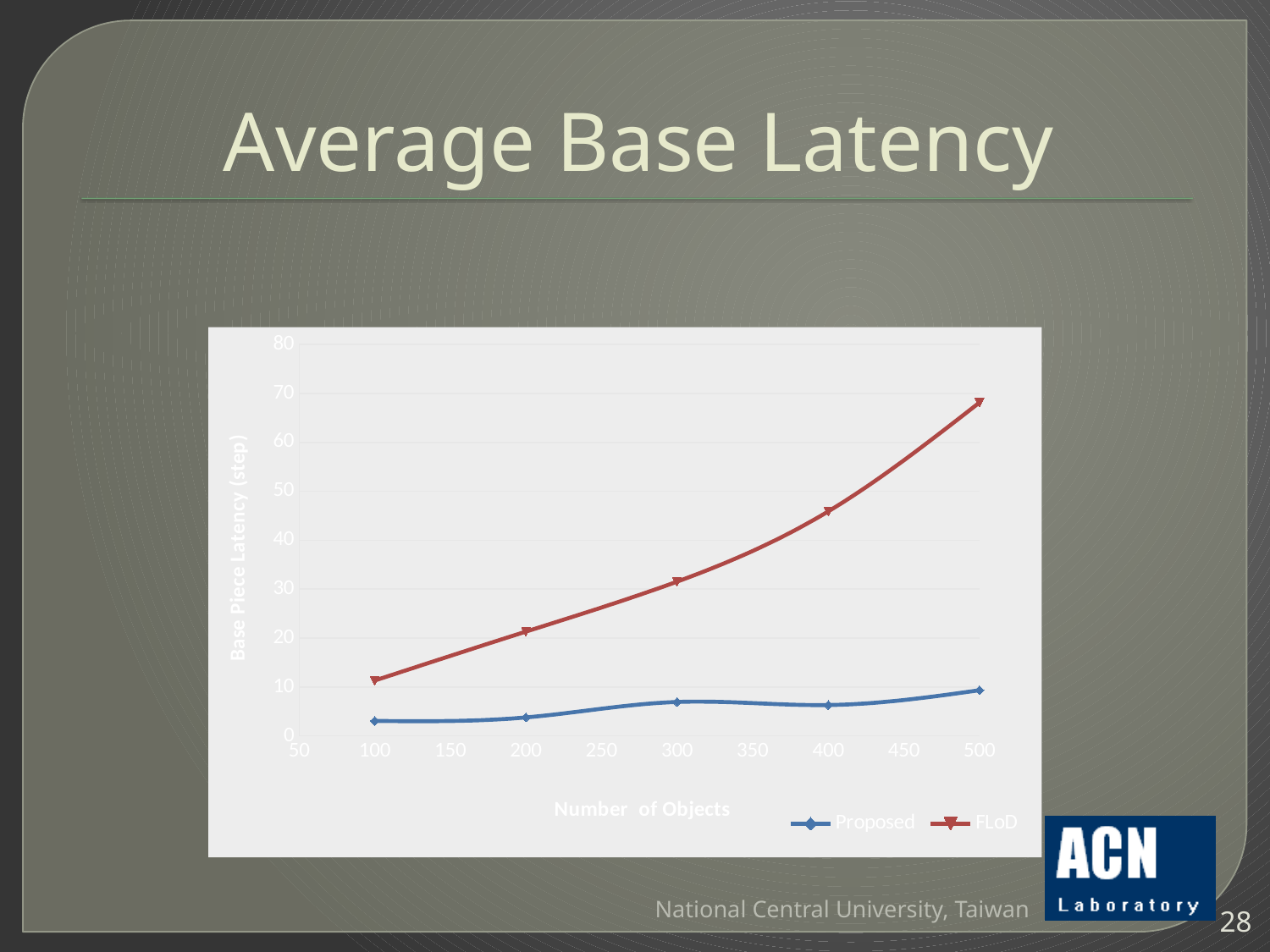
How many series does the legend list? 2 Is the value for FLoD at 100 objects greater or less than 20? less What is the label of the y axis? Base Piece Latency (step) Is the value for FLoD at 300 objects greater or less than 40? less At which number of objects does the FLoD series reach its highest value? 500 Does the FLoD series rise or fall as the number of objects increases? rise What kind of chart is shown on the slide? line chart Is the value for Proposed at 300 objects greater or less than 10? less How many data points are plotted for the FLoD series? 5 At 500 objects, which series has the larger value, Proposed or FLoD? FLoD